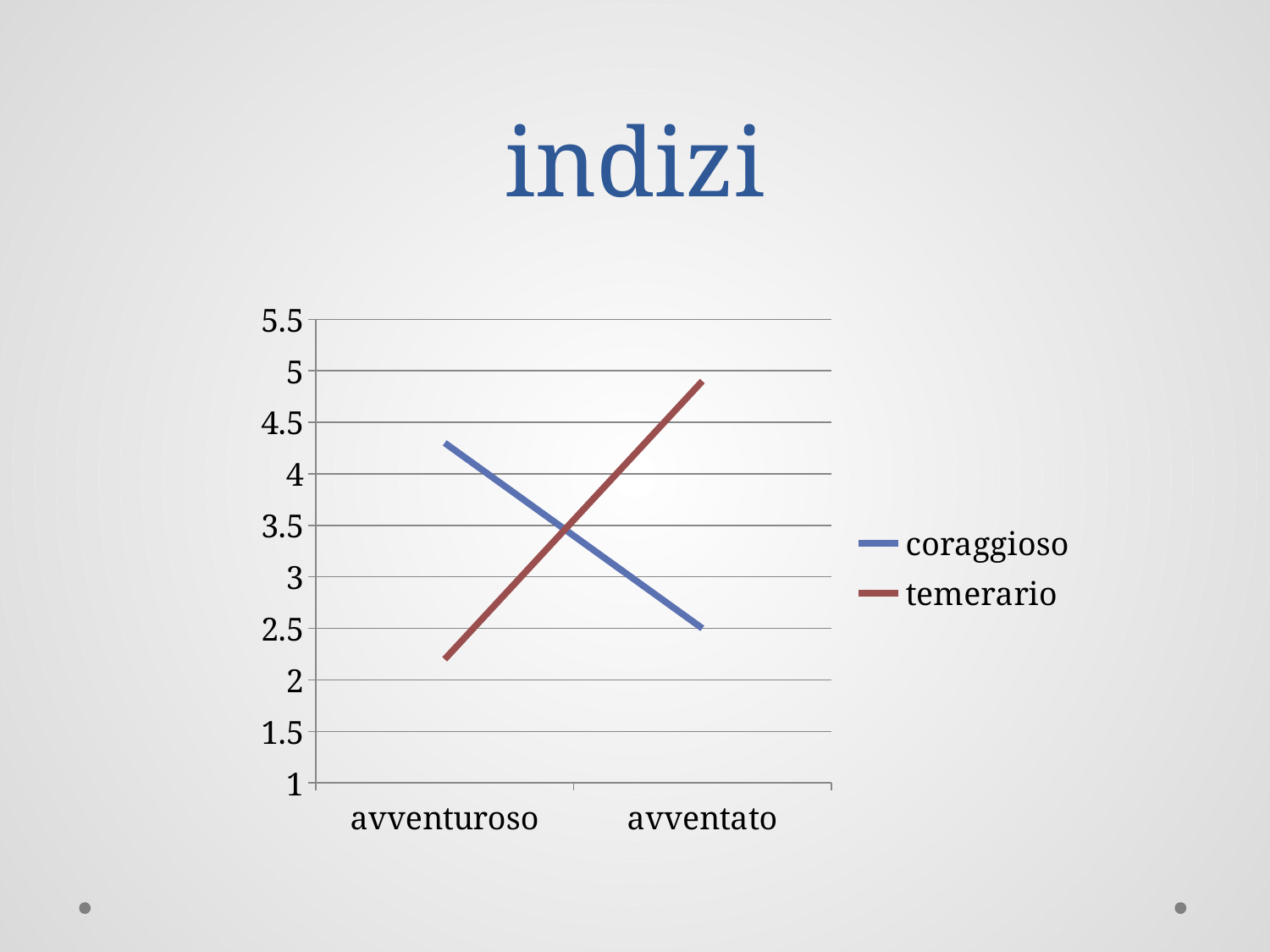
Is the value for temerario at avventato greater or less than 4.5? greater Does the coraggioso line rise or fall from avventuroso to avventato? fall Which colour is the coraggioso line? blue Is the value for coraggioso at avventuroso greater or less than 4? greater What kind of chart is shown on the slide? line chart Is the value for temerario at avventuroso greater or less than 2.5? less At avventuroso, which series has the higher value, coraggioso or temerario? coraggioso At avventato, which series has the higher value, coraggioso or temerario? temerario What is the title of the chart? indizi How many categories are shown on the x axis? 2 How many series does the legend list? 2